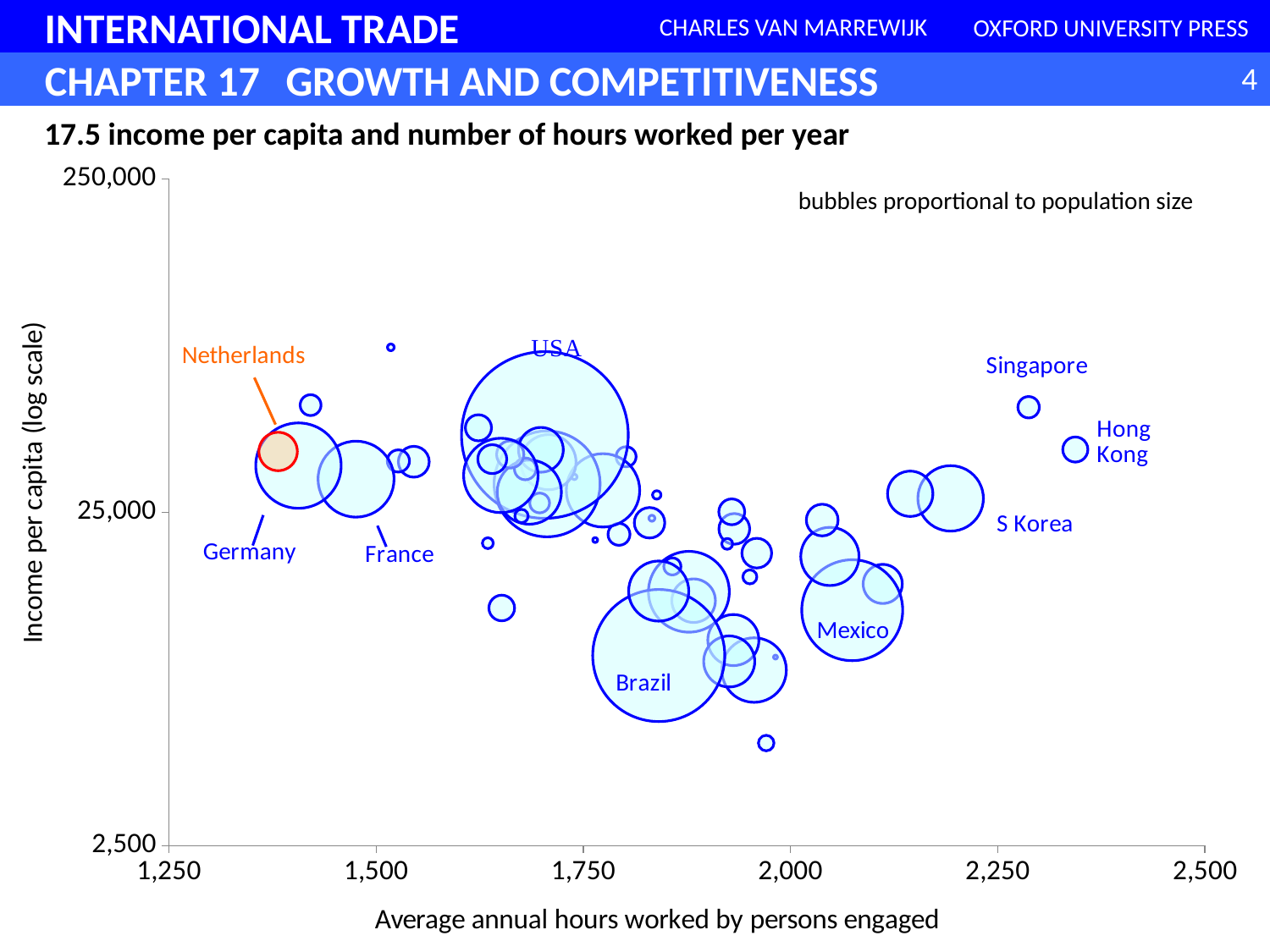
Is the average annual hours worked for Brazil greater or less than 2,000? less Is the income per capita for Brazil greater or less than 25,000? less Is the average annual hours worked for the Netherlands greater or less than 1,500? less What kind of chart is shown on the slide? Bubble chart According to the note on the chart, what are the bubble sizes proportional to? Population size Which labeled country has the largest bubble, i.e. the largest population? USA Which labeled country has the highest average annual hours worked? Hong Kong Which has the higher income per capita, the USA or Mexico? USA Which country's bubble is highlighted in orange/red on the chart? Netherlands